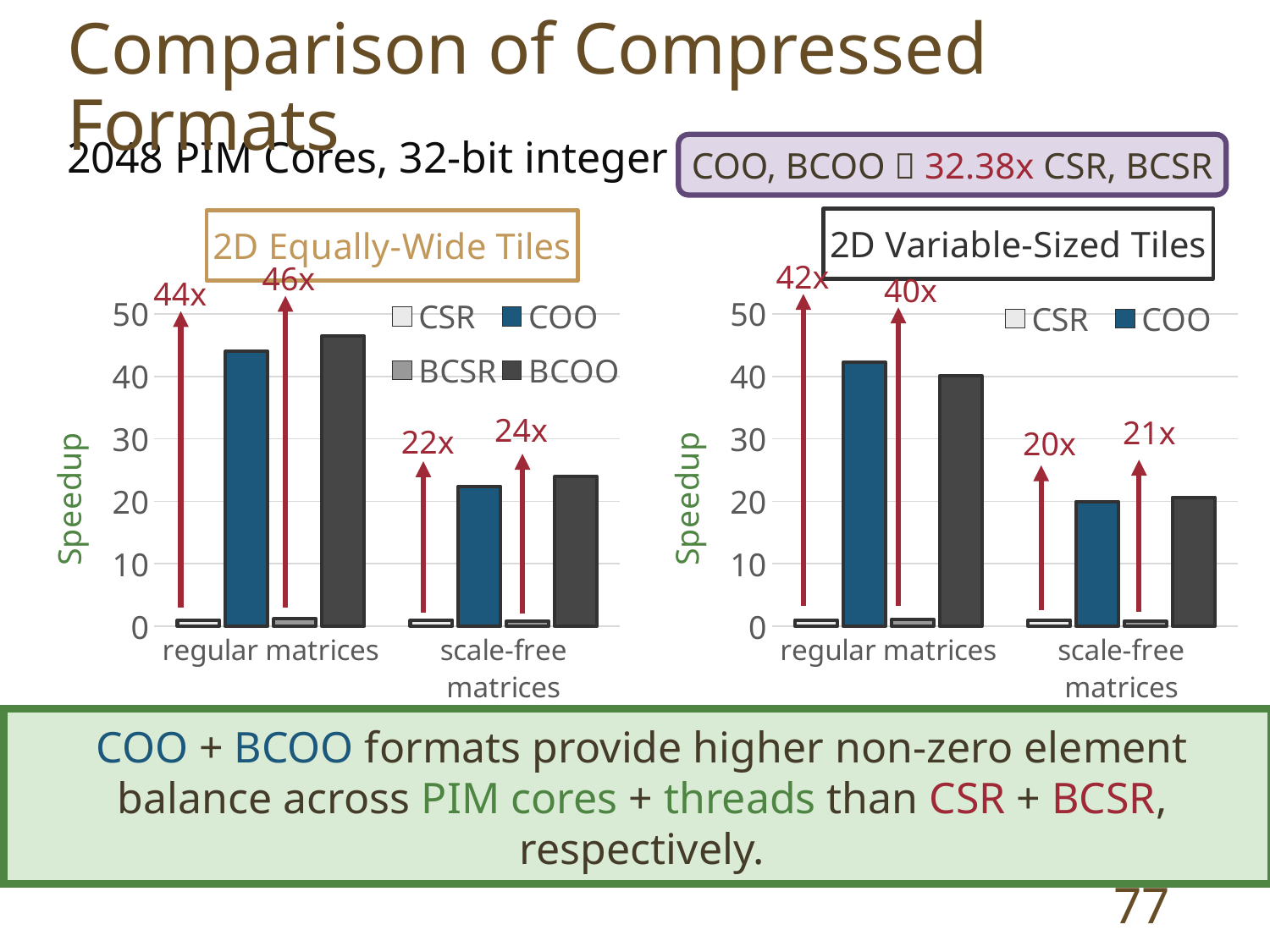
How many categories are shown on the x axis of the 2D Equally-Wide Tiles chart? 2 In the 2D Variable-Sized Tiles chart, is the BCOO speedup for scale-free matrices greater or less than 30? less In the 2D Variable-Sized Tiles chart, which has the larger speedup for regular matrices, CSR or COO? COO What kind of chart is the 2D Equally-Wide Tiles chart? bar chart What ratio is annotated above the COO bar for regular matrices in the 2D Equally-Wide Tiles chart? 44x How many series does the legend of the 2D Equally-Wide Tiles chart list? 4 What is the title of the chart on the right side of the slide? 2D Variable-Sized Tiles In the 2D Equally-Wide Tiles chart, is the COO speedup larger for regular matrices or for scale-free matrices? regular matrices In the 2D Equally-Wide Tiles chart, is the COO speedup for regular matrices greater or less than 40? greater In the 2D Variable-Sized Tiles chart, is the COO speedup for regular matrices greater or less than 30? greater In the 2D Equally-Wide Tiles chart, does the COO speedup rise or fall from regular matrices to scale-free matrices? fall